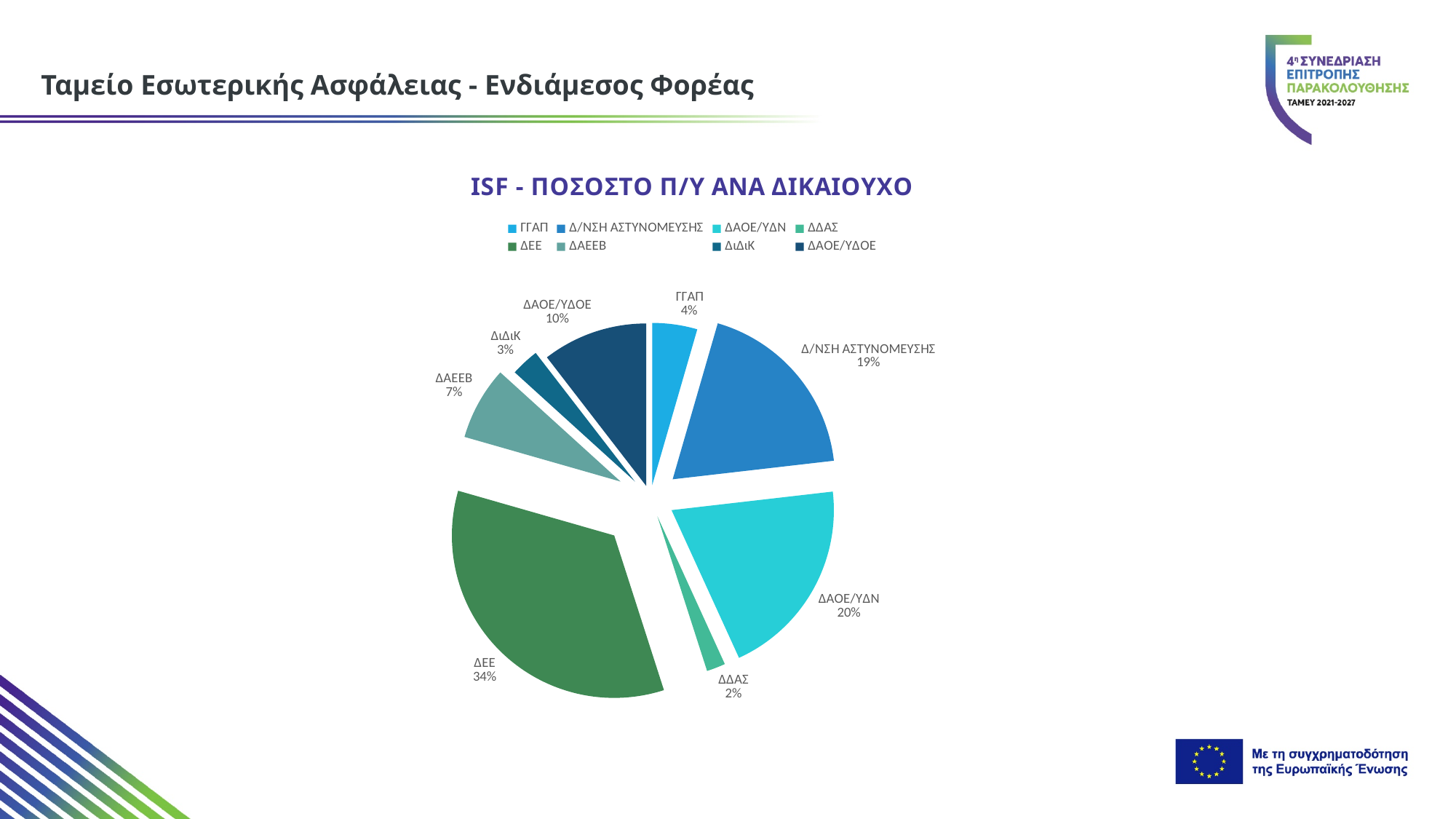
How many categories are shown in the pie chart? 8 What is the difference between the shares of ΔΕΕ and ΔΑΟΕ/ΥΔΝ? 14% Which category has the largest share of the pie? ΔΕΕ What share of the pie does ΔΕΕ hold? 34% What is the title of the chart? ISF - ΠΟΣΟΣΤΟ Π/Υ ΑΝΑ ΔΙΚΑΙΟΥΧΟ Which category has the smallest share of the pie? ΔΔΑΣ How many entries does the legend list? 8 Which is larger, the share of ΔΑΕΕΒ or the share of ΔιΔιΚ? ΔΑΕΕΒ What is the value shown for ΔΑΟΕ/ΥΔΟΕ? 10% What is the value shown for Δ/ΝΣΗ ΑΣΤΥΝΟΜΕΥΣΗΣ? 19% What is the value shown for ΔΑΟΕ/ΥΔΝ? 20% What type of chart is shown on the slide? pie chart